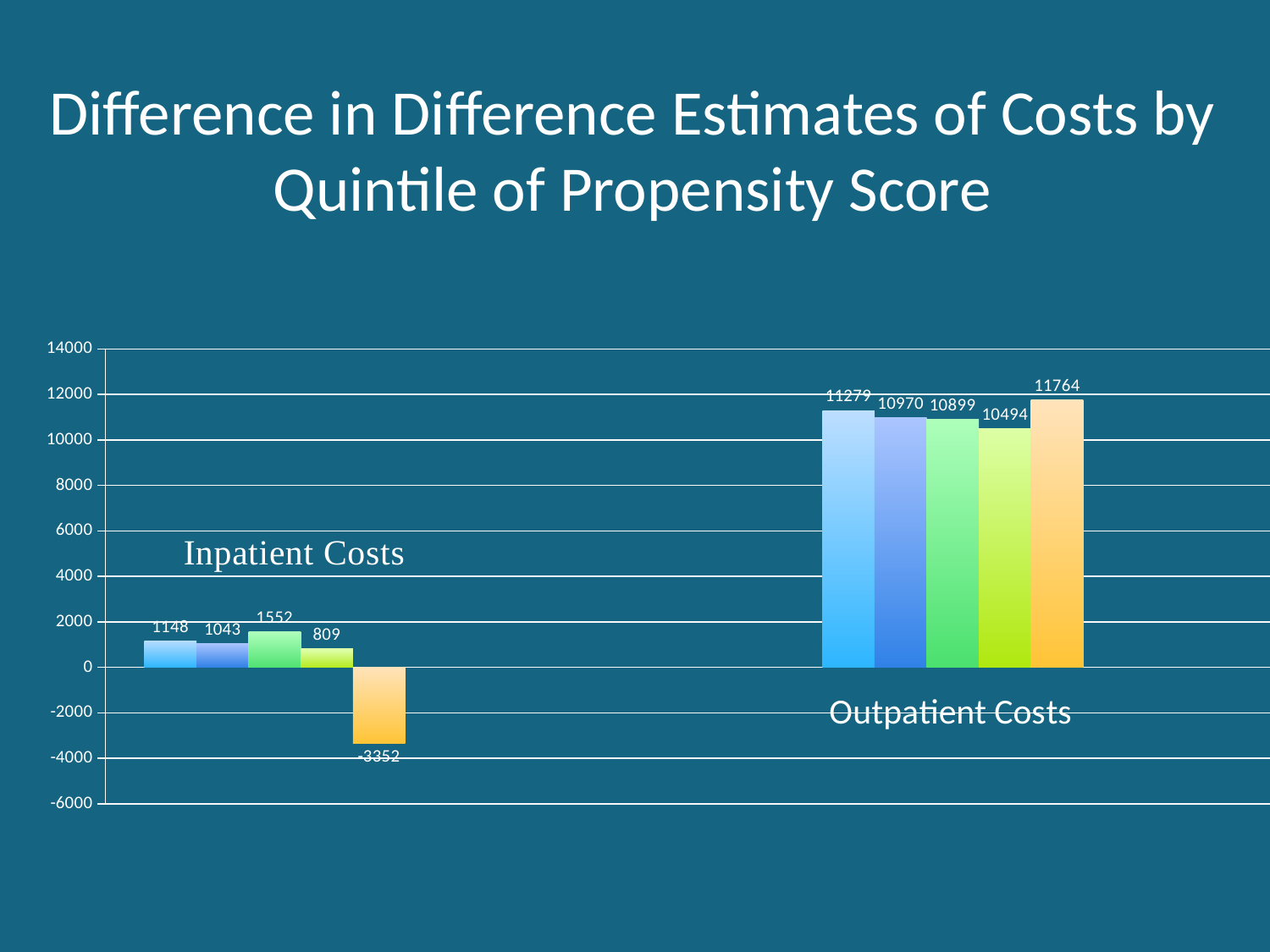
Which is larger: the second bar in the Outpatient Costs group (10970) or the third bar (10899)? 10970 How many bars are in the Inpatient Costs group? 5 What is the title of the slide containing the chart? Difference in Difference Estimates of Costs by Quintile of Propensity Score Which bar in the Inpatient Costs group has the highest value? 1552 How many category groups are shown on the x axis? 2 What is the difference between the highest and lowest bars in the Outpatient Costs group (11764 and 10494)? 1270 What is the value of the negative bar in the Inpatient Costs group? -3352 What type of chart is shown on the slide? bar chart What is the value of the first (leftmost) bar in the Inpatient Costs group? 1148 Which bar in the Outpatient Costs group has the lowest value? 10494 What is the difference between the first two bars in the Inpatient Costs group (1148 and 1043)? 105 What is the value of the last (rightmost) bar in the Outpatient Costs group? 11764